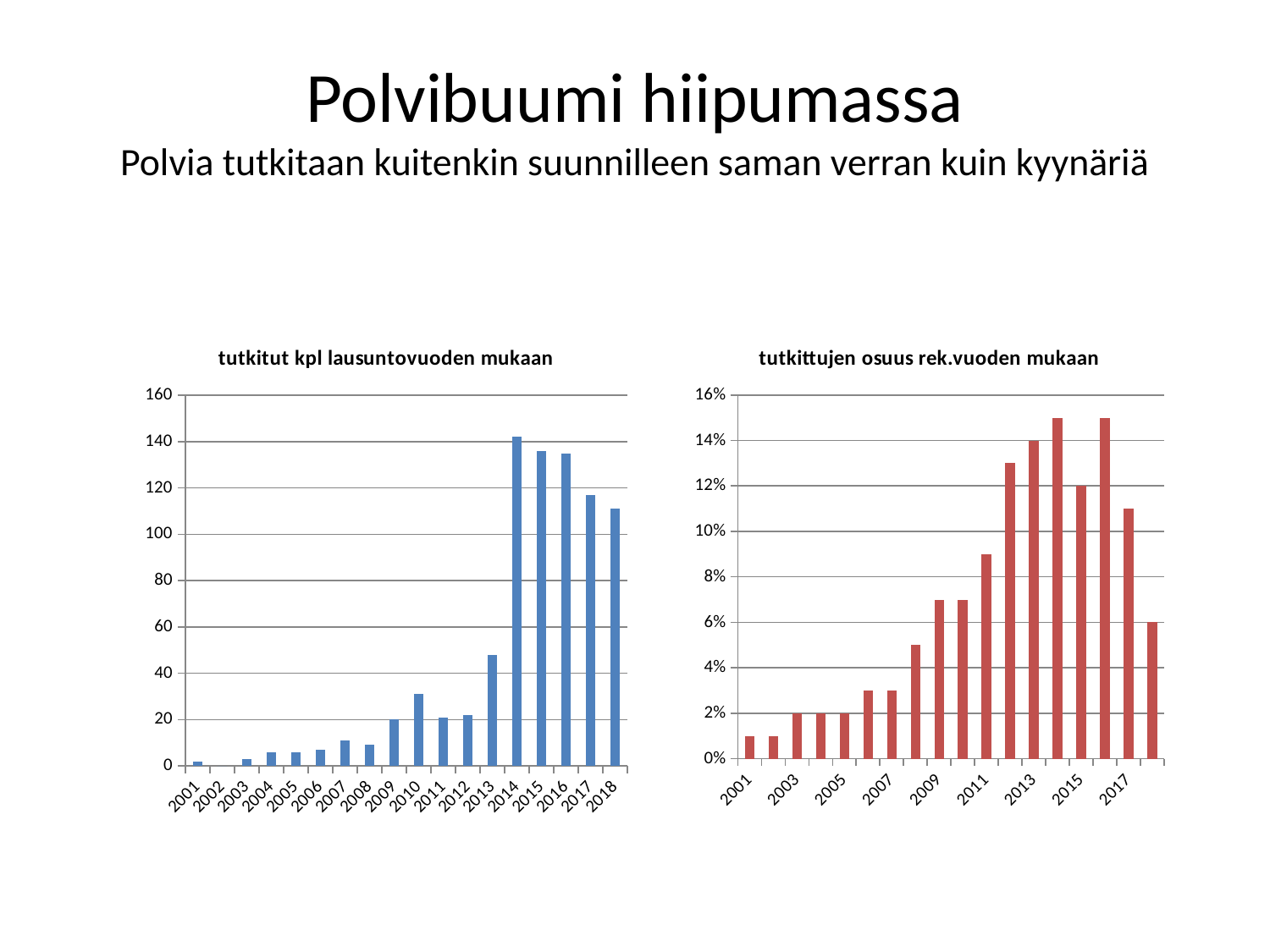
In the right chart "tutkittujen osuus rek.vuoden mukaan", is the value for 2011 greater or less than 8%? greater In the left chart "tutkitut kpl lausuntovuoden mukaan", is the value for 2013 greater or less than 60? less In the right chart "tutkittujen osuus rek.vuoden mukaan", what is the value for 2015? 12% In the left chart "tutkitut kpl lausuntovuoden mukaan", which is larger, the value for 2014 or the value for 2018? 2014 What kind of chart is the left chart titled "tutkitut kpl lausuntovuoden mukaan"? bar chart In the left chart "tutkitut kpl lausuntovuoden mukaan", how many years are shown on the x axis? 18 In the left chart "tutkitut kpl lausuntovuoden mukaan", is the value for 2010 greater or less than 20? greater In the right chart "tutkittujen osuus rek.vuoden mukaan", what is the value for 2003? 2% In the right chart "tutkittujen osuus rek.vuoden mukaan", what is the value for 2013? 14% In the left chart "tutkitut kpl lausuntovuoden mukaan", which year has the highest value? 2014 In the right chart "tutkittujen osuus rek.vuoden mukaan", what is the difference between the values for 2013 and 2015? 2%